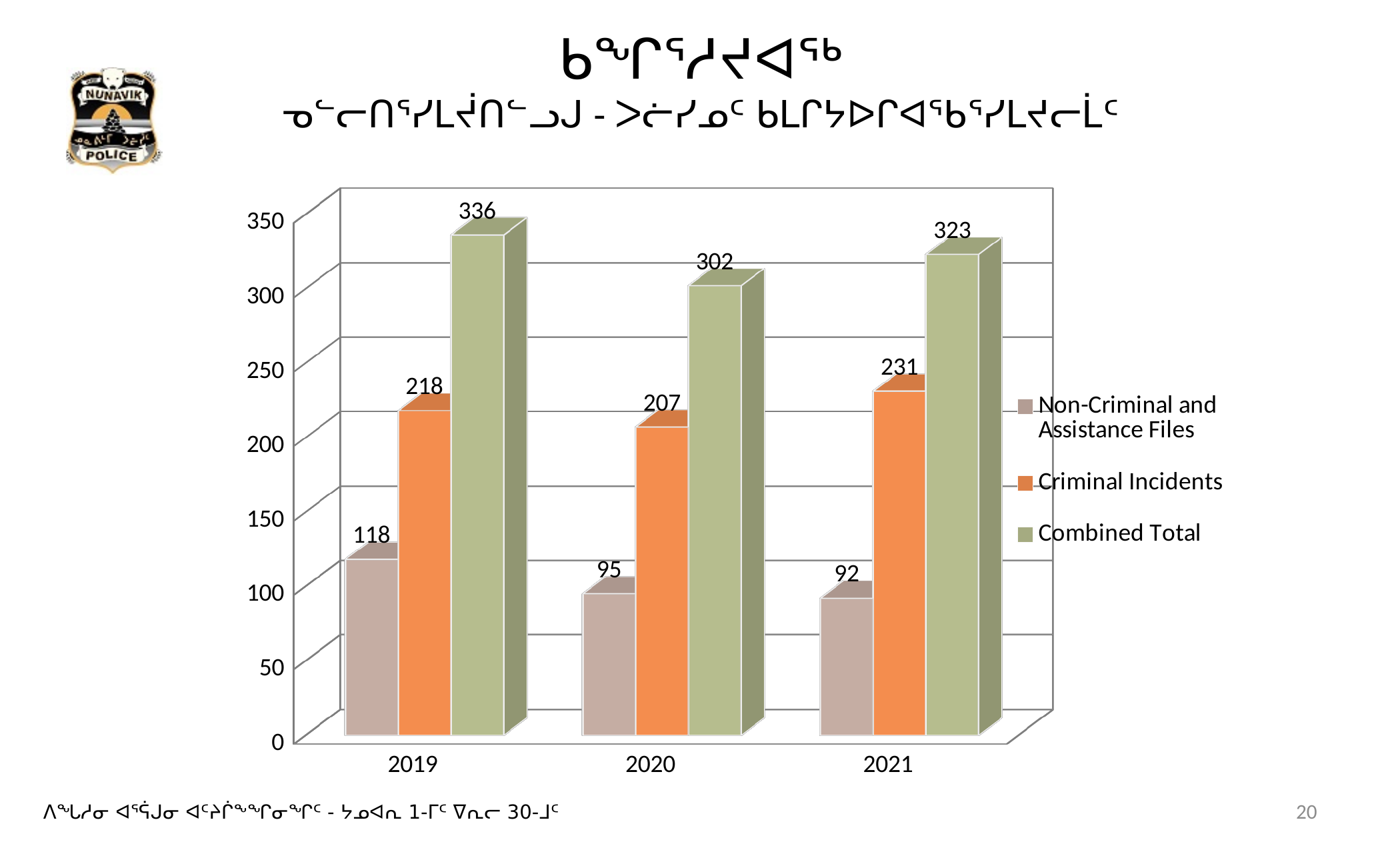
What is the value for Non-Criminal and Assistance Files in 2019? 118 What is the difference between the Combined Total in 2019 and in 2020? 34 How many series does the legend list? 3 Which year has the highest Combined Total? 2019 How many years are shown on the x axis? 3 What kind of chart is shown on the slide? Bar chart Do the Criminal Incidents values rise or fall from 2020 to 2021? Rise Which year has the lowest value for Non-Criminal and Assistance Files? 2021 What is the Combined Total for 2021? 323 What is the value for Criminal Incidents in 2020? 207 What is the difference between Criminal Incidents in 2021 and in 2019? 13 Which is larger: Criminal Incidents in 2021 or Criminal Incidents in 2019? Criminal Incidents in 2021